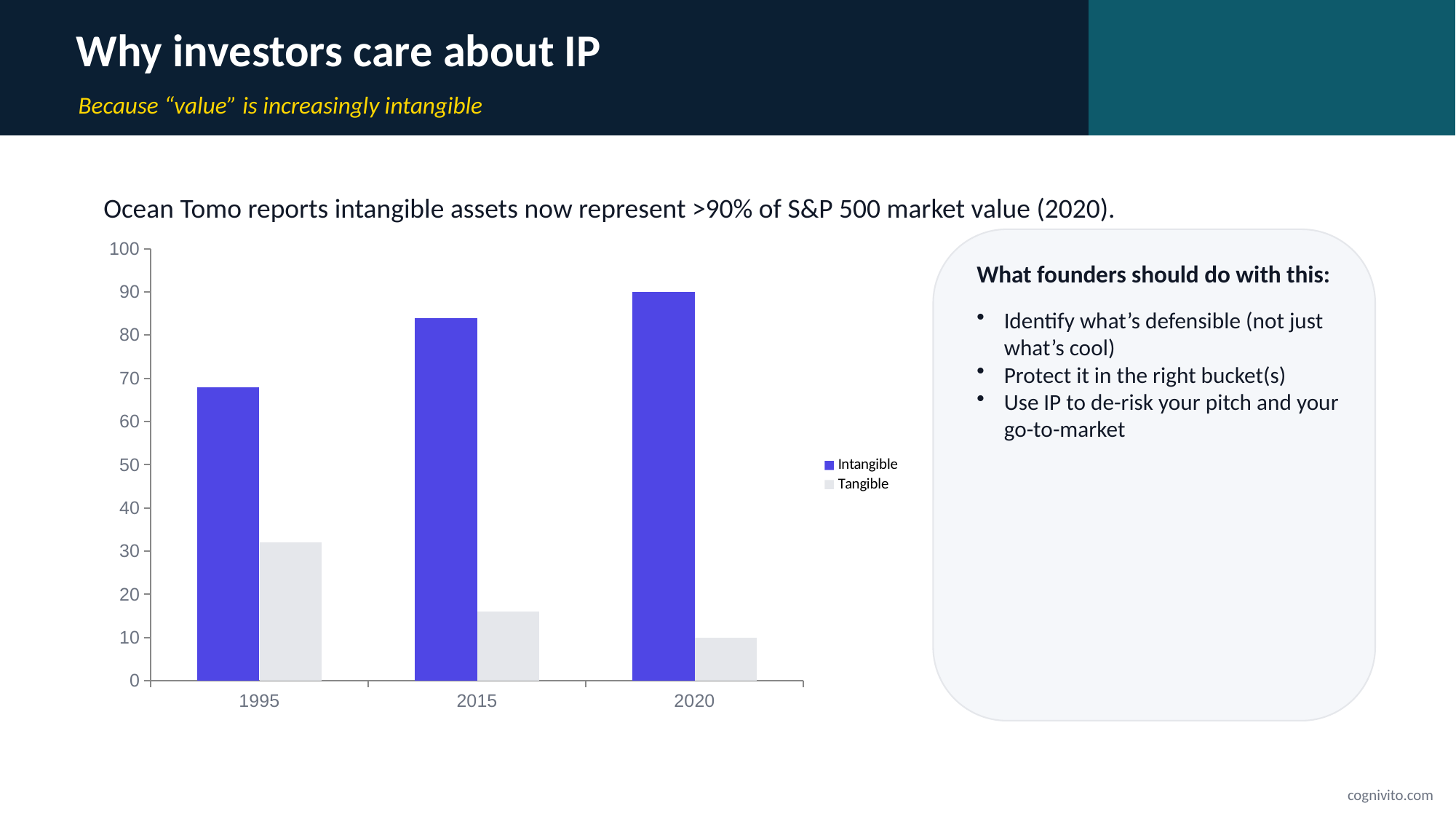
Which series does the purple bar represent in the chart? Intangible In which year is the Intangible bar highest? 2020 What kind of chart is shown on the slide? bar chart How many series does the chart legend list? 2 Is the Tangible value for 2015 greater or less than 20? less In which year is the Tangible bar highest? 1995 How many years are shown on the x axis of the chart? 3 In 1995, which is larger, the Intangible bar or the Tangible bar? Intangible In which year is the Tangible bar lowest? 2020 Is the Intangible value for 1995 greater or less than 60? greater Do the Intangible values rise or fall from 1995 to 2020? rise Do the Tangible values rise or fall from 1995 to 2020? fall